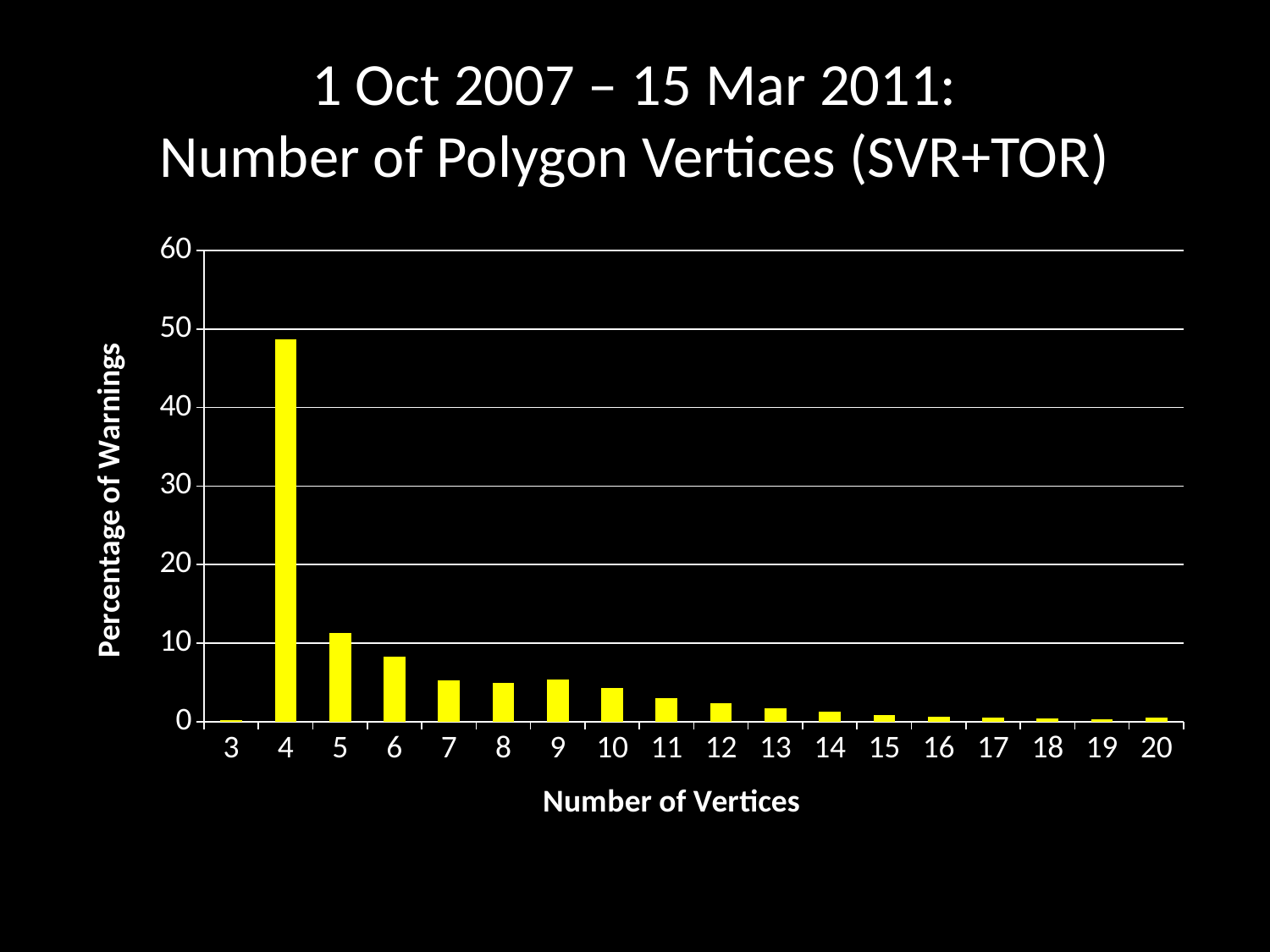
From 4 vertices onward, do the percentages generally rise or fall as the number of vertices increases? fall Which has a higher percentage of warnings, 10 vertices or 11 vertices? 10 vertices What is the label of the x axis? Number of Vertices What is the label of the y axis? Percentage of Warnings Which number of vertices has the highest percentage of warnings? 4 Is the percentage of warnings for 4 vertices greater or less than 50? less How many vertex-count categories are shown on the x axis? 18 Is the percentage of warnings for 5 vertices greater or less than 20? less Which has a higher percentage of warnings, 5 vertices or 6 vertices? 5 vertices Is the percentage of warnings for 6 vertices greater or less than 10? less What kind of chart is shown on the slide? bar chart